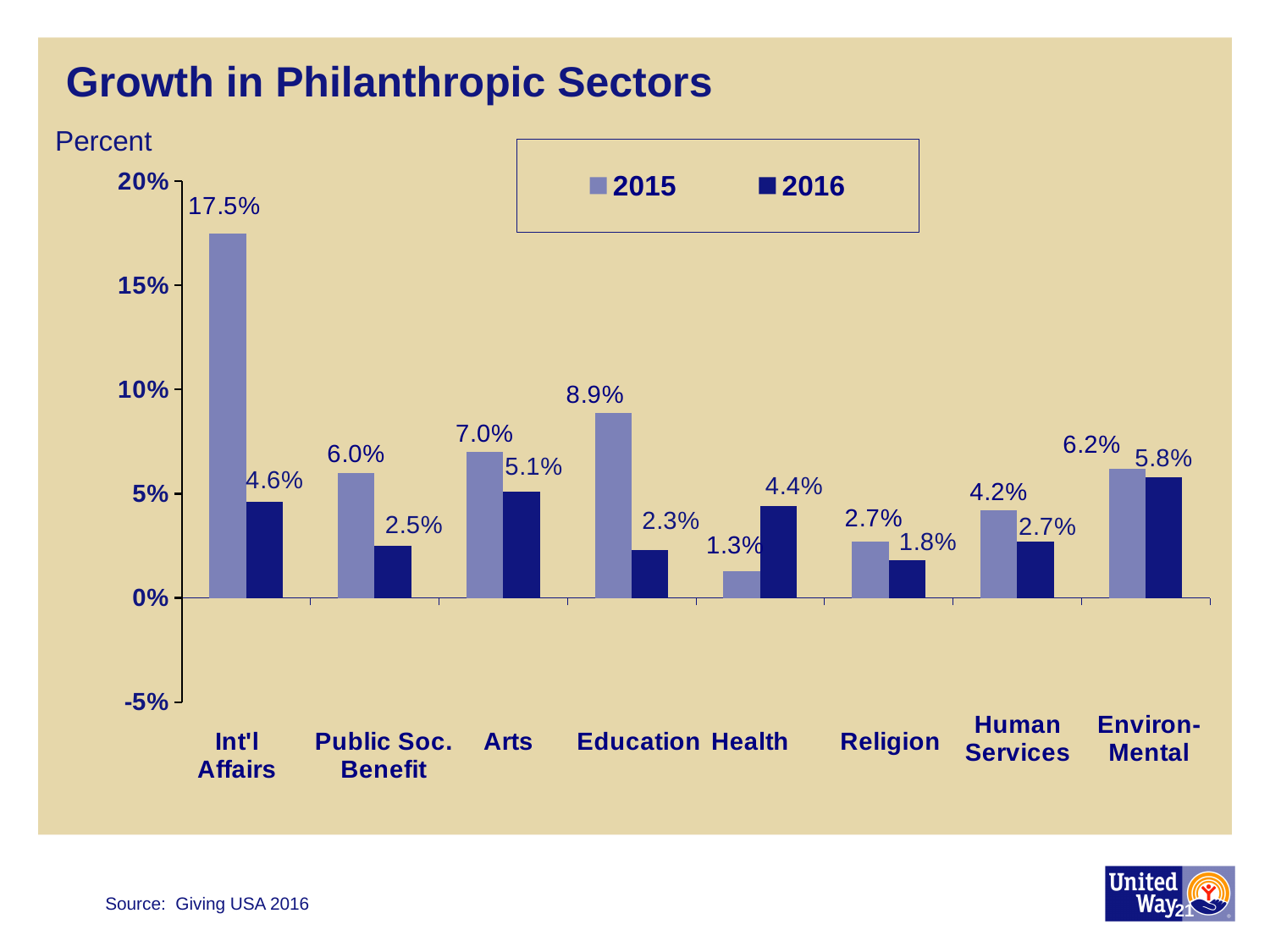
Which category has the lowest 2015 value? Health What kind of chart is shown? Bar chart How many series does the legend list? 2 Which category has the highest 2015 value? Int'l Affairs Which category has the lowest 2016 value? Religion How many categories are shown on the x axis? 8 What is the 2016 value for Health? 4.4% What is the title of the chart? Growth in Philanthropic Sectors Which is larger for Health, the 2015 value or the 2016 value? 2016 What is the 2015 value for Int'l Affairs? 17.5% What is the difference between the 2015 and 2016 values for Education? 6.6% What is the 2016 value for Environ-Mental? 5.8%